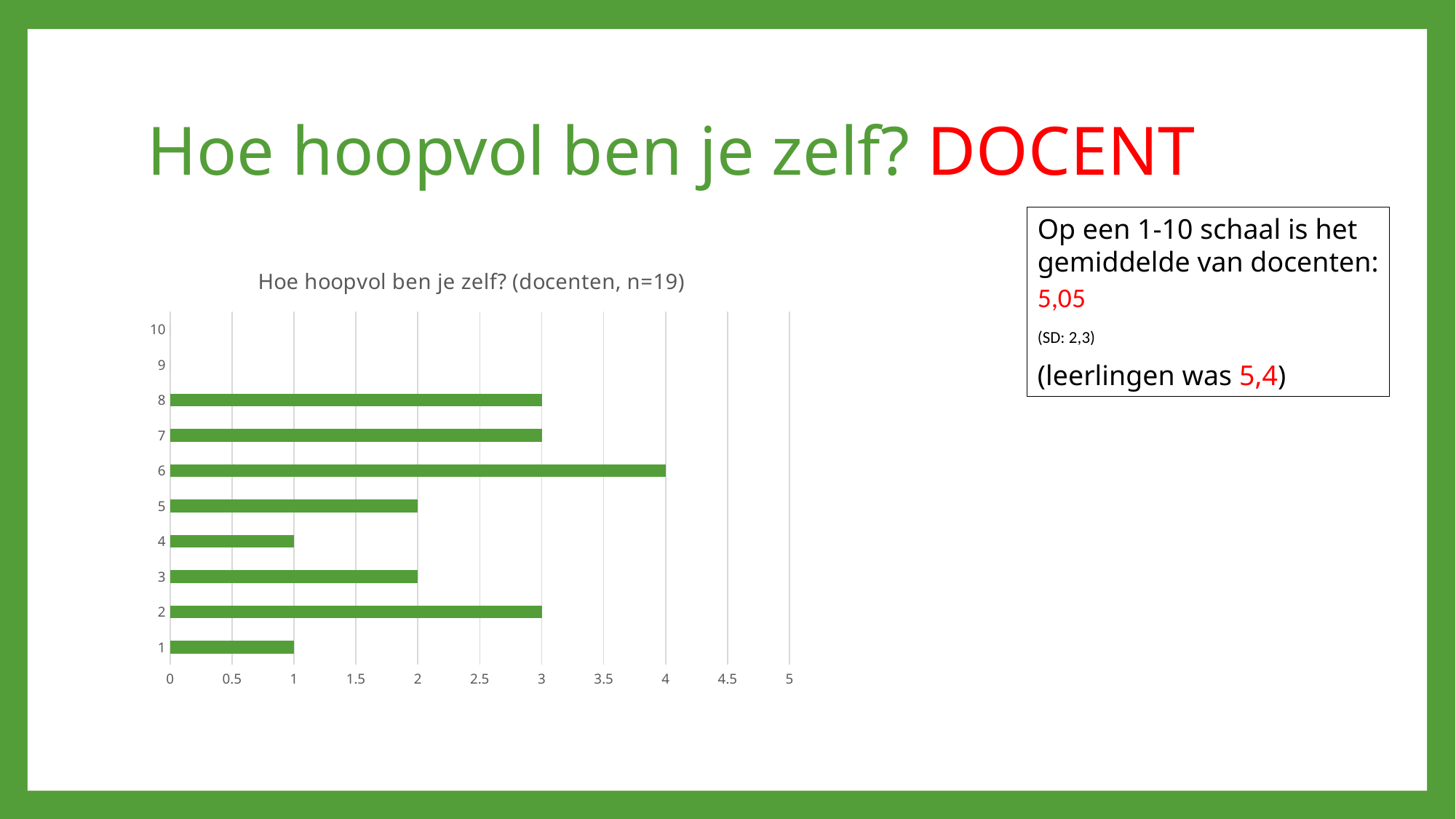
Is the value for category 7 greater or less than 2.5? greater Which category has the longest bar in the chart? 6 What is the value for category 2? 3 What type of chart is shown on the slide? bar chart What is the difference between the values for category 6 and category 4? 3 Which has a larger value, category 2 or category 5? 2 How many categories are listed on the vertical axis of the chart? 10 What is the highest value shown on the horizontal axis of the chart? 5 What is the value for category 4? 1 What is the value for category 5? 2 What is the title of the chart? Hoe hoopvol ben je zelf? (docenten, n=19) What is the value for category 6? 4